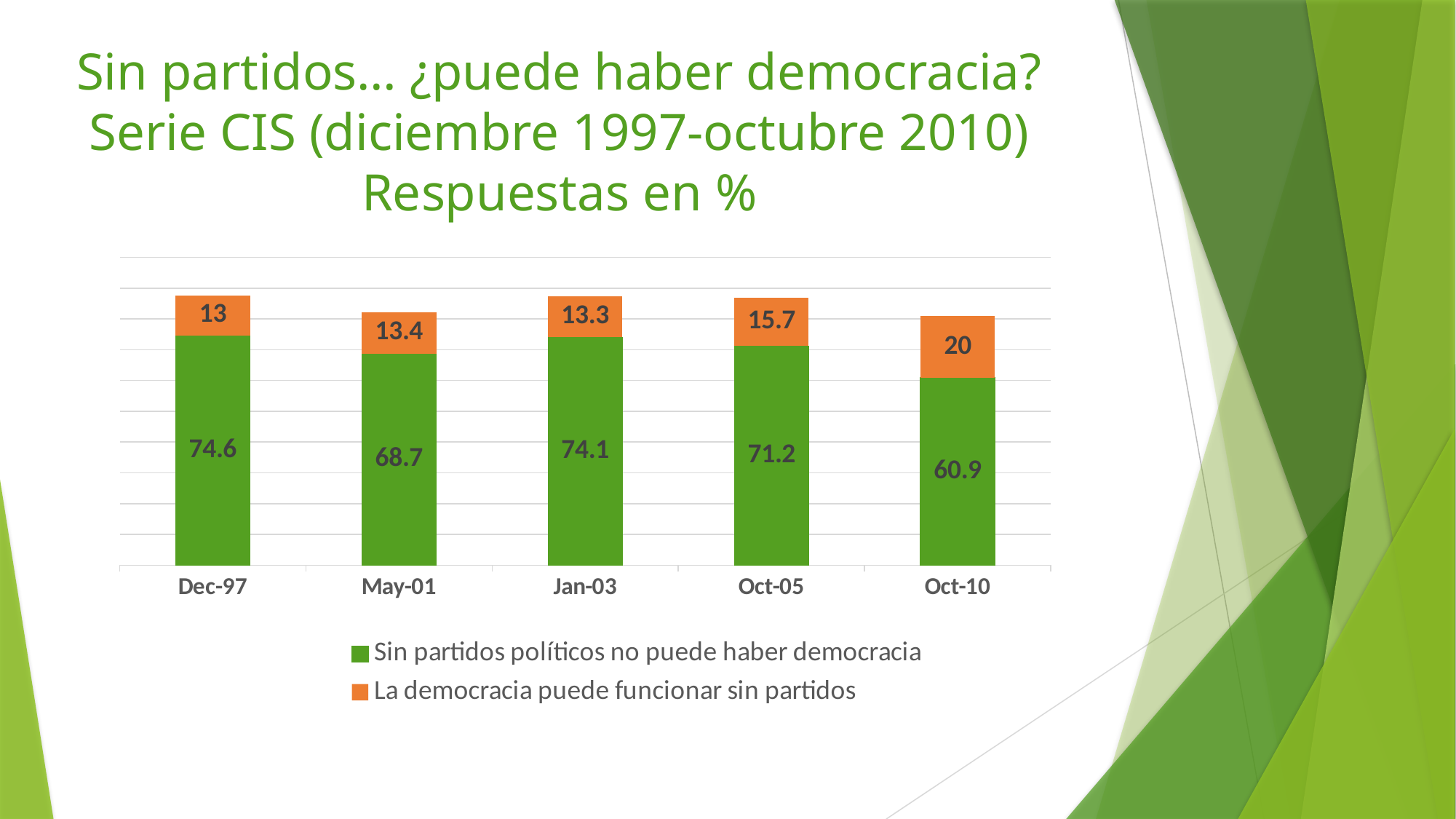
At which date is the value for 'Sin partidos políticos no puede haber democracia' highest? Dec-97 How many dates are shown on the x axis? 5 What kind of chart is shown on the slide? Stacked bar chart What is the value for 'La democracia puede funcionar sin partidos' at Oct-05? 15.7 What is the value for 'La democracia puede funcionar sin partidos' at Oct-10? 20 Which is larger: the 'La democracia puede funcionar sin partidos' value at Jan-03 or at Oct-10? Oct-10 At which date is the value for 'La democracia puede funcionar sin partidos' lowest? Dec-97 What is the value for 'Sin partidos políticos no puede haber democracia' at Dec-97? 74.6 What is the value for 'Sin partidos políticos no puede haber democracia' at May-01? 68.7 What is the difference between the 'Sin partidos políticos no puede haber democracia' values at Dec-97 and Oct-10? 13.7 What is the total of the stacked bar at Oct-10? 80.9 How many series does the legend list? 2